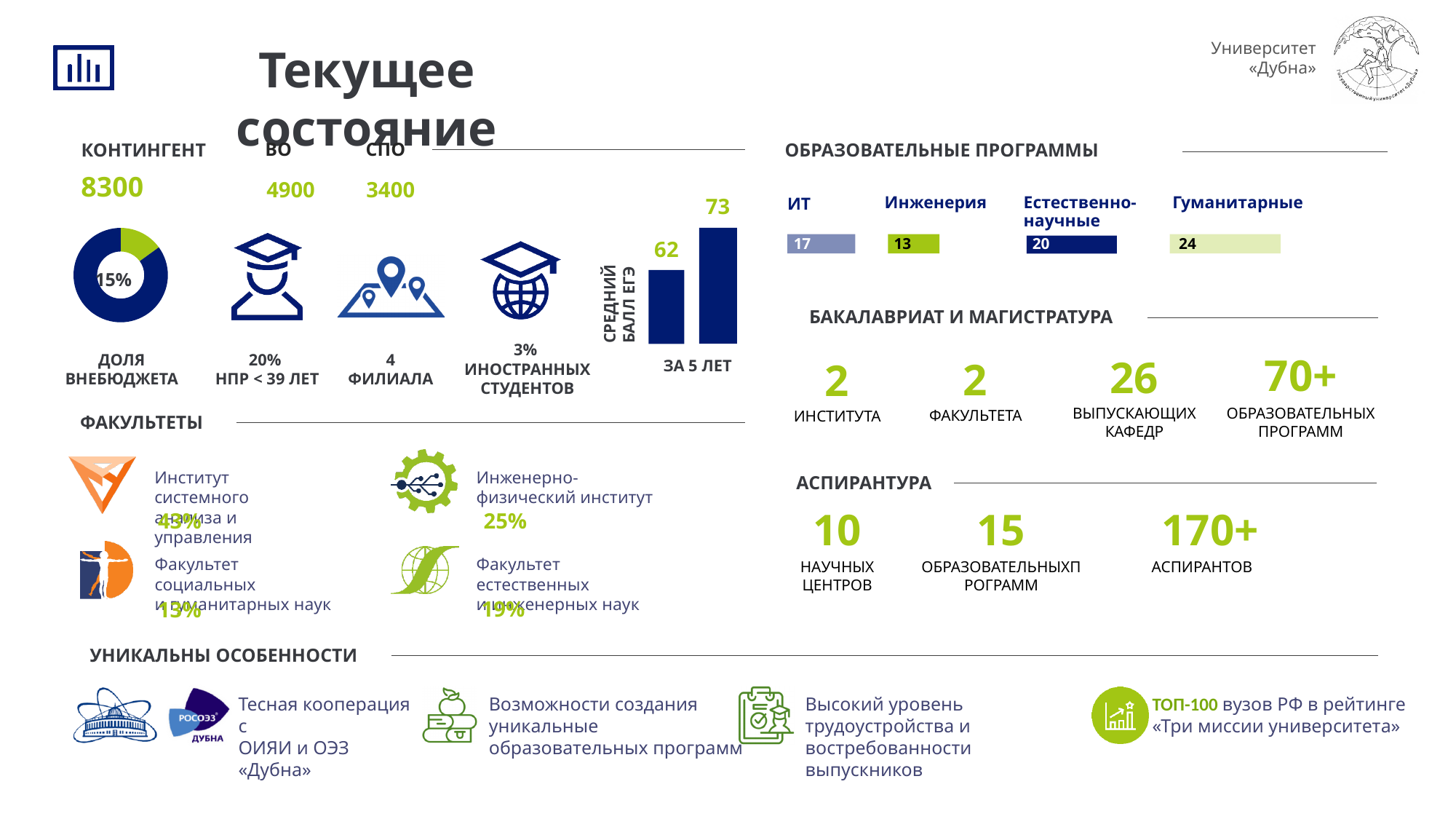
What kind of chart is the 'Средний балл ЕГЭ' chart? bar chart In the 'Образовательные программы' chart, which category has the lowest value? Инженерия In the 'Средний балл ЕГЭ' chart, what is the difference between the two bars? 11 In the 'Средний балл ЕГЭ' chart, what is the value of the right bar? 73 In the 'Образовательные программы' chart, what is the difference between Гуманитарные and Естественно-научные? 4 In the 'Средний балл ЕГЭ' chart, do the values rise or fall from left to right? rise In the 'Средний балл ЕГЭ' chart, how many bars are plotted? 2 In the 'Образовательные программы' chart, which category has the highest value? Гуманитарные In the donut chart under 'Контингент', what share is labelled for 'Доля внебюджета'? 15% In the 'Образовательные программы' chart, how many categories are shown? 4 In the 'Средний балл ЕГЭ' chart, what is the value of the left bar? 62 In the 'Образовательные программы' chart, what is the value for ИТ? 17